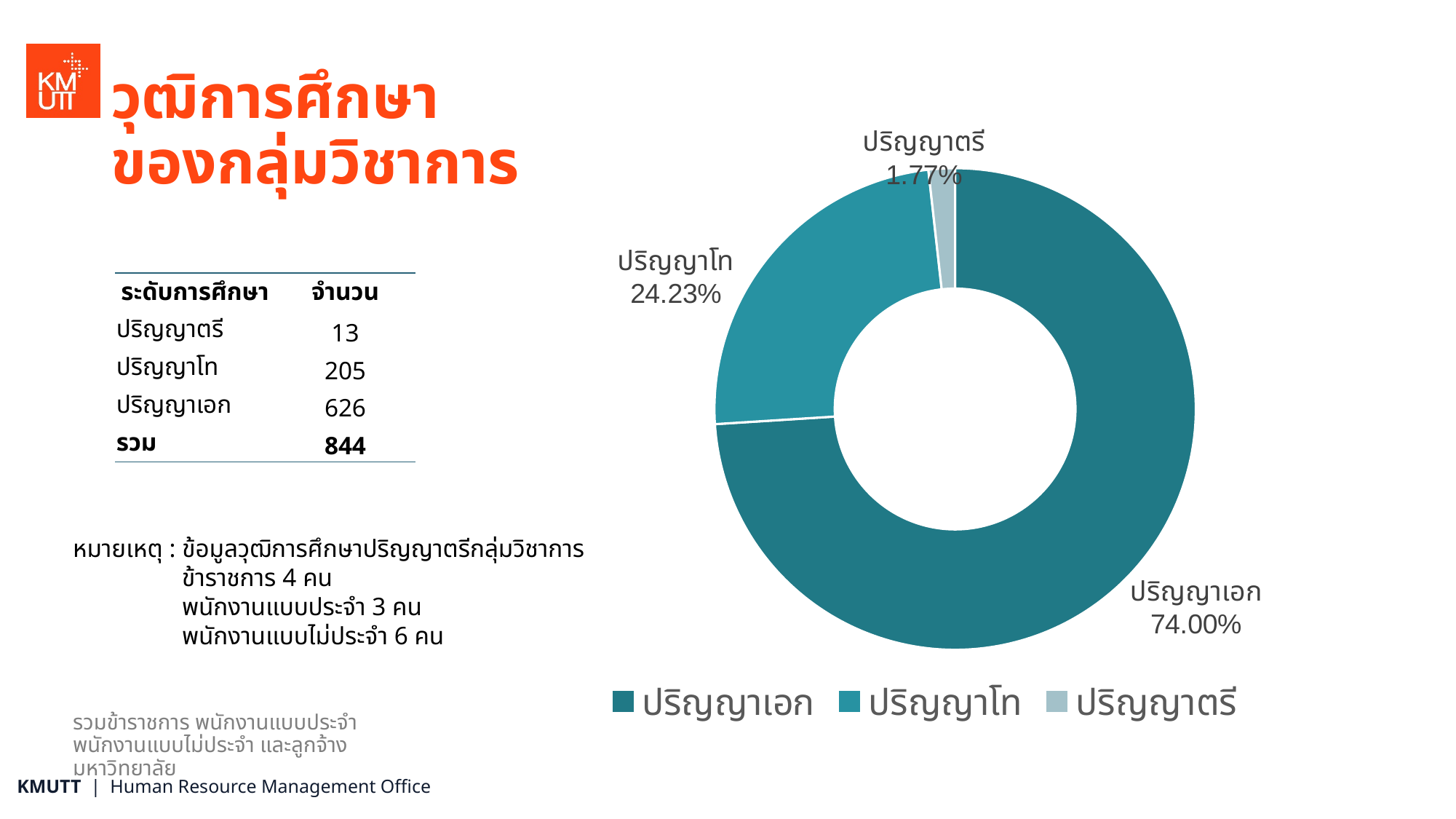
What percentage does the ปริญญาโท slice show in the doughnut chart? 24.23% By how many percentage points does the ปริญญาเอก share exceed the ปริญญาโท share? 49.77 percentage points How many entries does the chart legend list? 3 What percentage does the ปริญญาเอก slice show in the doughnut chart? 74.00% How many slices does the doughnut chart have? 3 Which education level has the largest slice in the chart? ปริญญาเอก What percentage does the ปริญญาตรี slice show in the doughnut chart? 1.77% What share of the chart does ปริญญาโท account for? 24.23% Which education level has the smallest slice in the chart? ปริญญาตรี Which legend entry is shown in the lightest colour? ปริญญาตรี What type of chart is shown on the slide? Doughnut (pie) chart Which slice is larger, ปริญญาโท or ปริญญาตรี? ปริญญาโท